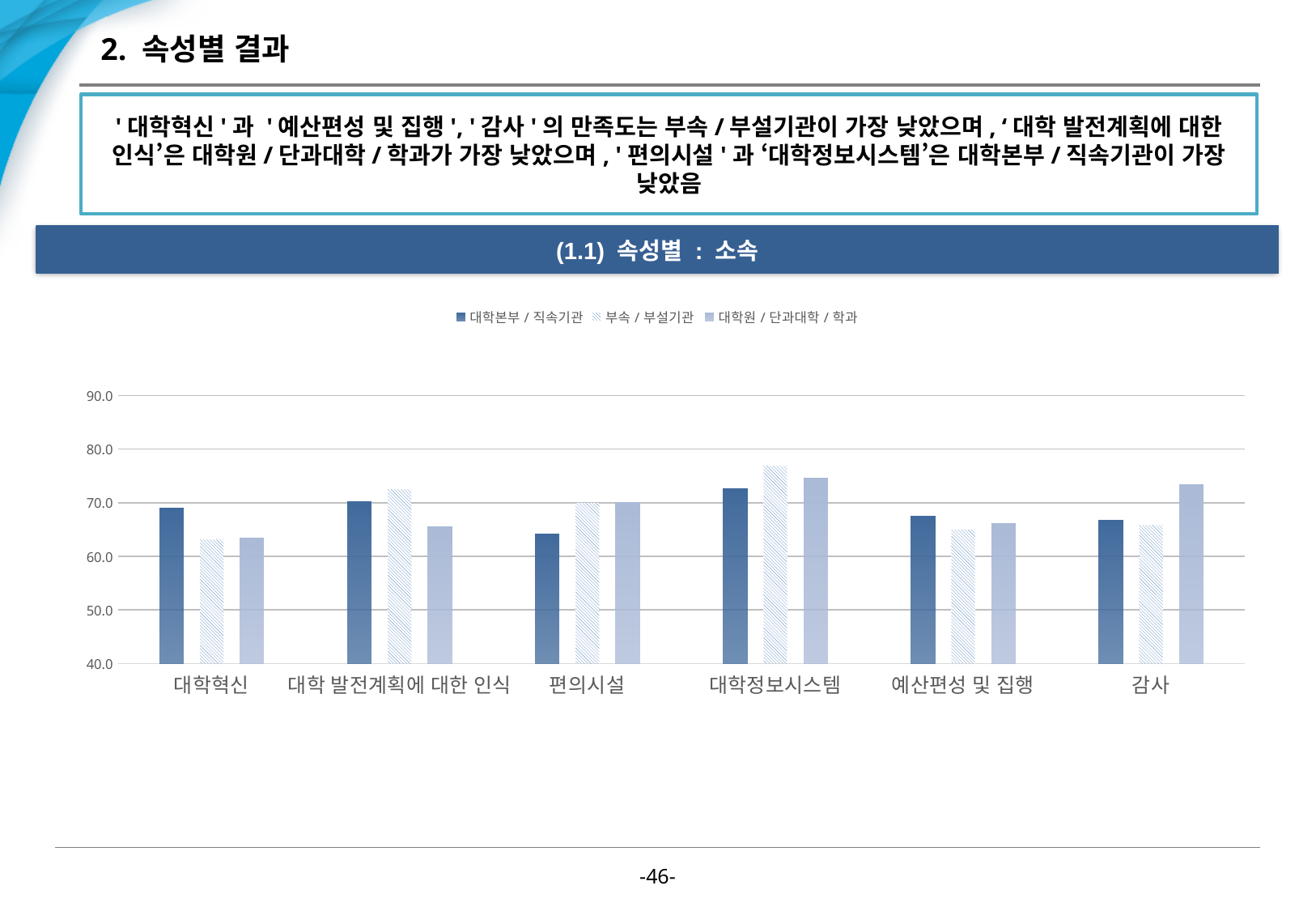
How many series does the chart legend list? 3 Which series has the highest value in the 감사 category? 대학원 / 단과대학 / 학과 Which is larger: the 부속 / 부설기관 value for 대학정보시스템 or the 부속 / 부설기관 value for 대학혁신? 대학정보시스템 How many categories are shown along the x axis of the chart? 6 Is the value for 대학본부 / 직속기관 in the 편의시설 category greater or less than 70? less What is the title shown in the banner above the chart? (1.1) 속성별 : 소속 Is the value for 부속 / 부설기관 in the 대학혁신 category greater or less than 60? greater Which series has the highest value in the 대학정보시스템 category? 부속 / 부설기관 Is the value for 부속 / 부설기관 in the 대학정보시스템 category greater or less than 70? greater Which series has the lowest value in the 편의시설 category? 대학본부 / 직속기관 What kind of chart is shown on the slide? bar chart Which series has the highest value in the 대학혁신 category? 대학본부 / 직속기관